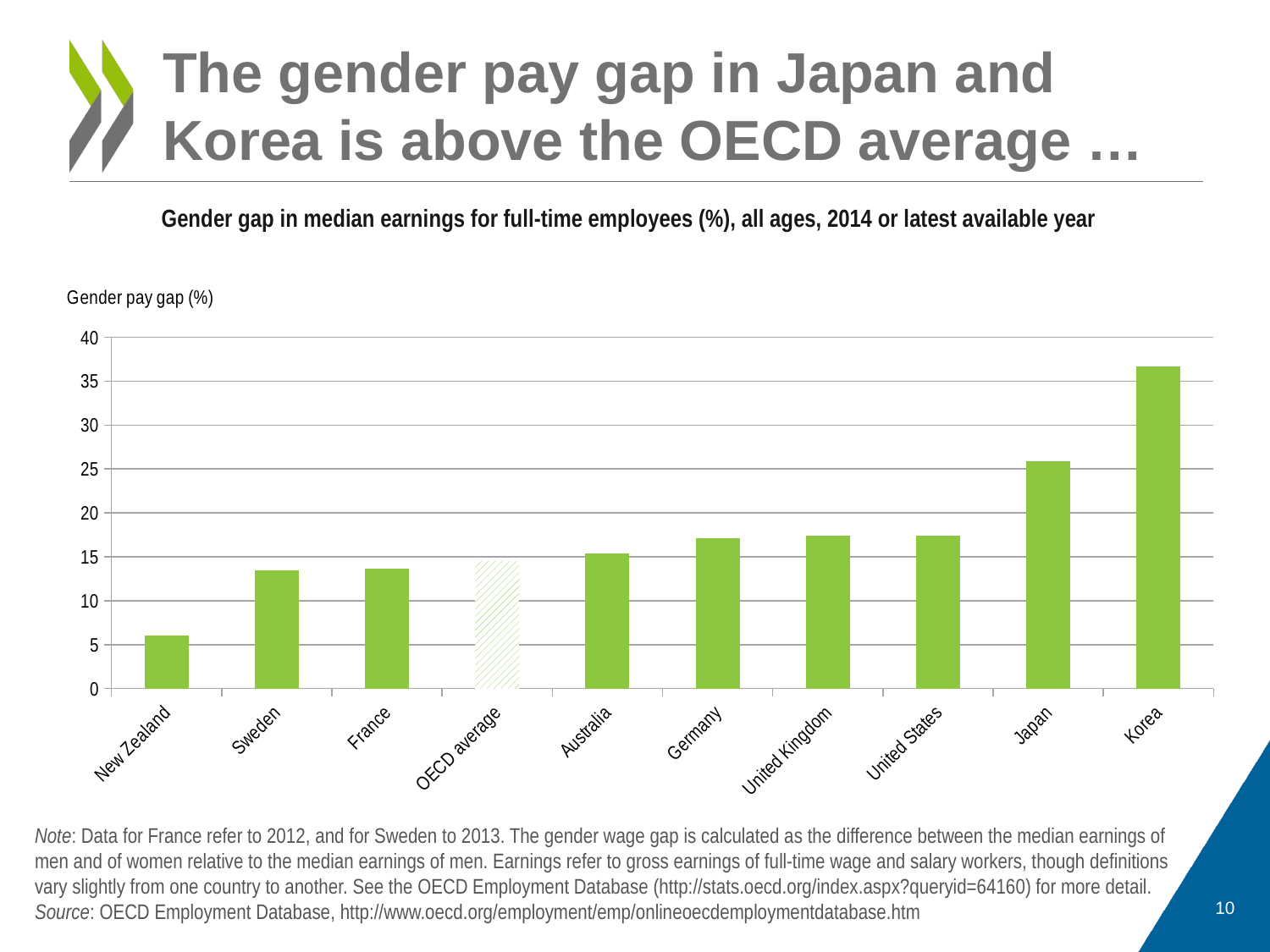
Is the value for Germany greater or less than 20? less What kind of chart is shown on the slide? bar chart Which is larger, the value for Japan or the value for Germany? Japan Is the value for Korea greater or less than 35? greater What is the label on the vertical axis of the chart? Gender pay gap (%) Which category has the lowest gender pay gap? New Zealand Is the value for New Zealand greater or less than 10? less Which category has the highest gender pay gap? Korea How many categories are plotted on the x axis? 10 Do the values generally rise or fall moving from left to right along the x axis? rise